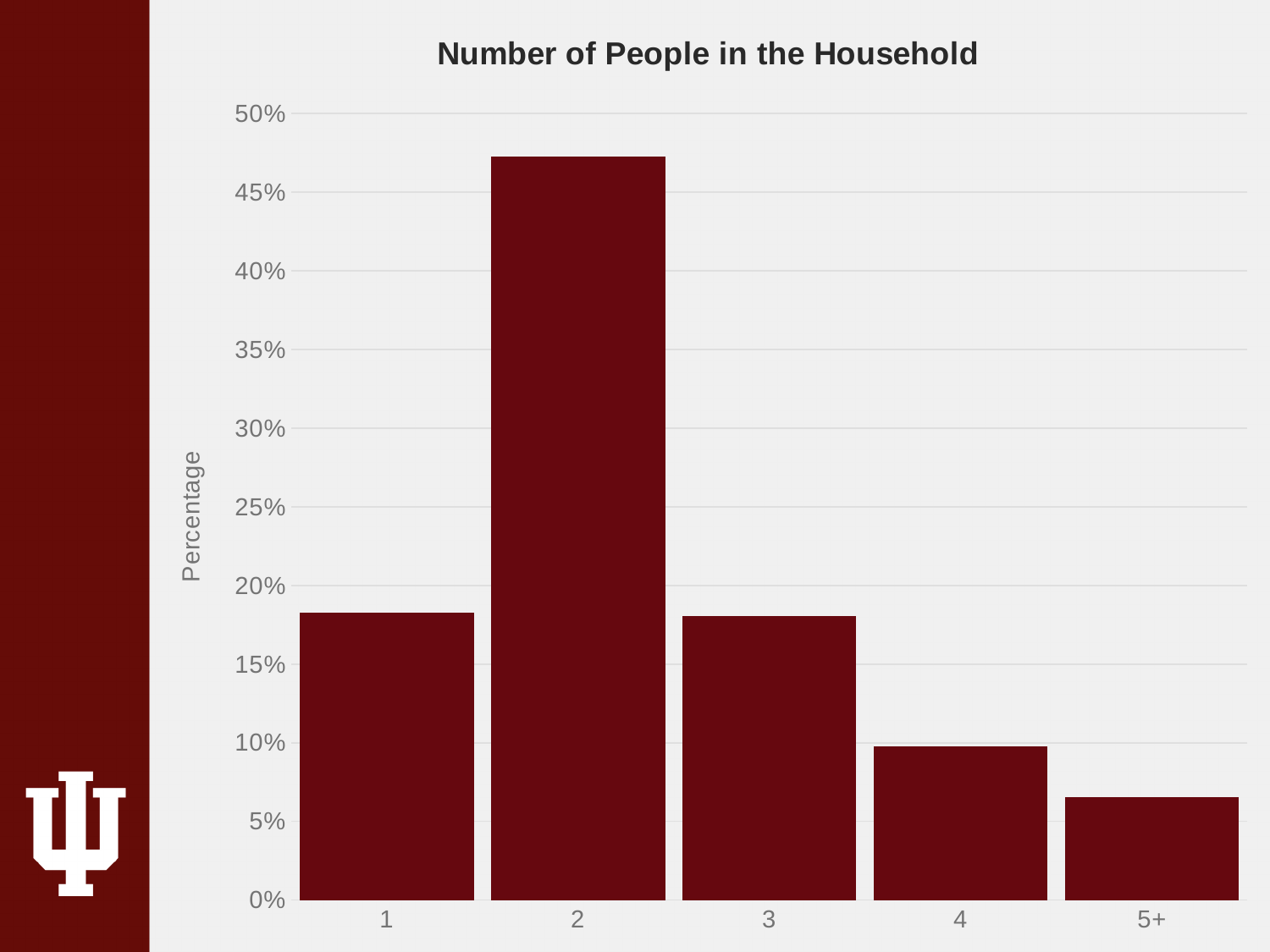
Which household size has the highest percentage? 2 What is the title of the chart? Number of People in the Household Is the value for household size 4 greater or less than 5%? greater What kind of chart is shown on the slide? bar chart Which has a larger percentage, household size 4 or household size 5+? 4 Which household size has the lowest percentage? 5+ Is the value for household size 5+ greater or less than 10%? less How many categories are shown on the x axis of the chart? 5 Is the value for household size 1 greater or less than 15%? greater Do the values rise or fall from household size 2 to 5+? fall Which has a larger percentage, household size 2 or household size 3? 2